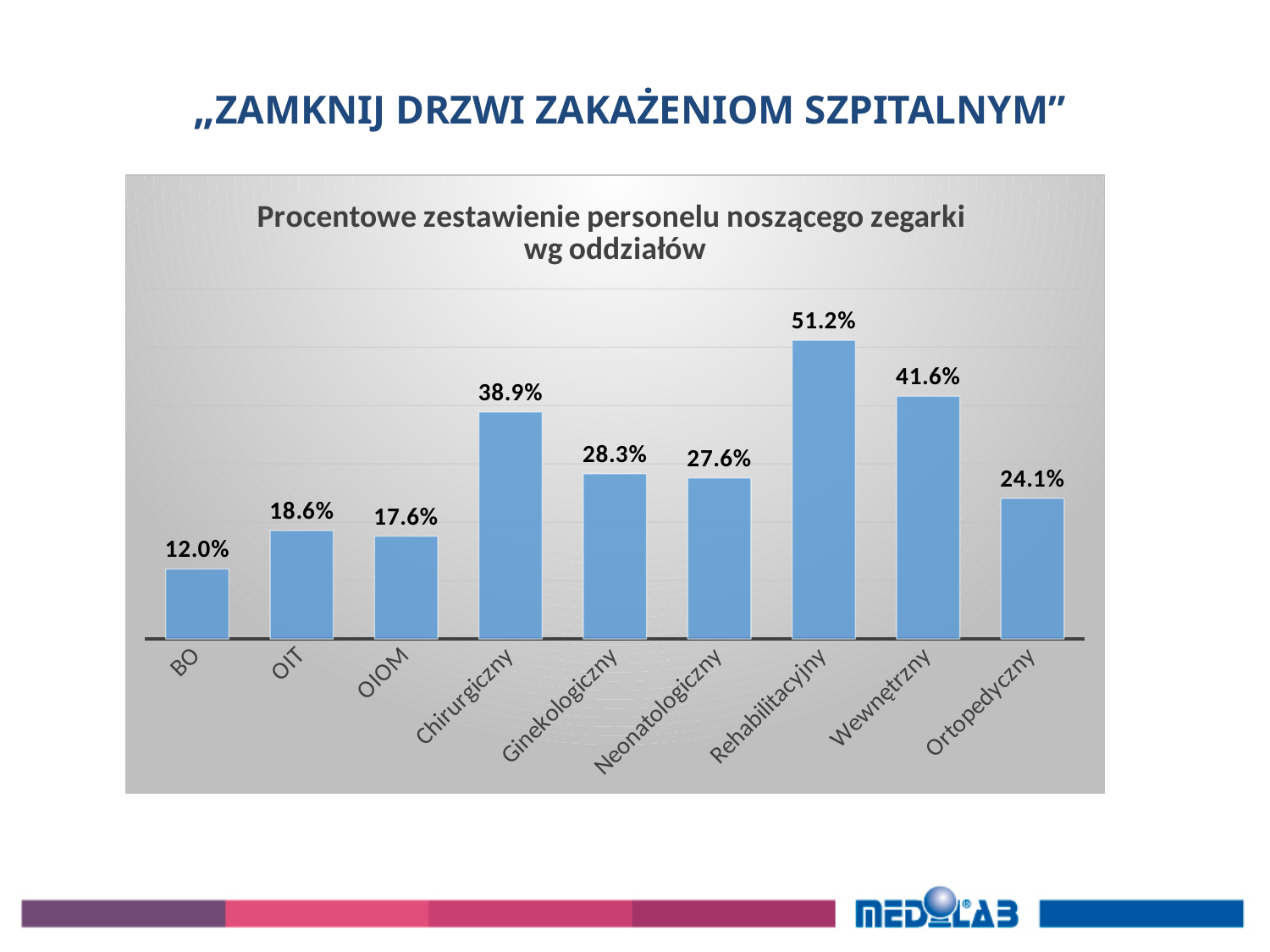
What is the value shown for Ortopedyczny? 24.1% What percentage of staff wear watches in the Rehabilitacyjny department? 51.2% Which department has the lowest percentage of staff wearing watches? BO What is the difference between the values for OIT and OIOM? 1.0% What is the difference between the values for Rehabilitacyjny and Wewnętrzny? 9.6% How many departments are shown on the chart? 9 Which department has the highest percentage of staff wearing watches? Rehabilitacyjny What type of chart is shown on the slide? Bar chart Which is larger, the value for Ginekologiczny or the value for Neonatologiczny? Ginekologiczny What is the title of the chart? Procentowe zestawienie personelu noszącego zegarki wg oddziałów What is the value shown for Chirurgiczny? 38.9% What is the value shown for BO? 12.0%